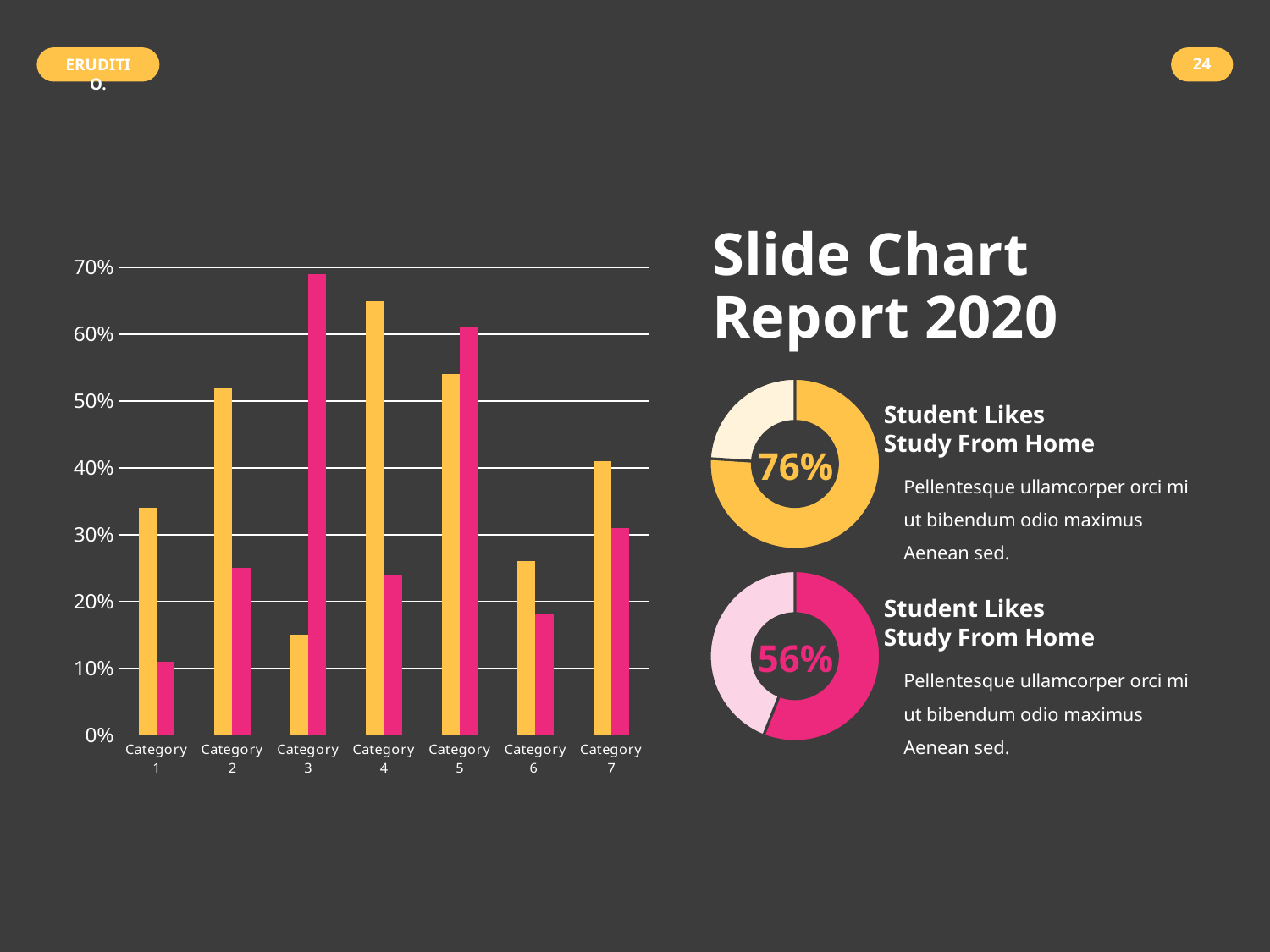
In the bar chart on the left, which category has the tallest yellow bar? Category 4 In the bar chart on the left, for Category 2, which bar is taller, the yellow or the pink? yellow In the bar chart on the left, is the pink bar for Category 3 greater or less than 60%? greater In the bar chart on the left, how many categories are shown on the x axis? 7 In the bar chart on the left, which category has the tallest pink bar? Category 3 In the bar chart on the left, is the pink bar for Category 1 greater or less than 20%? less In the bar chart on the left, is the yellow bar for Category 3 greater or less than 20%? less What percentage is shown in the centre of the lower (pink) donut chart? 56% What percentage is shown in the centre of the upper (yellow) donut chart? 76% In the bar chart on the left, which category has the shortest pink bar? Category 1 What kind of chart is the large chart on the left of the slide? bar chart